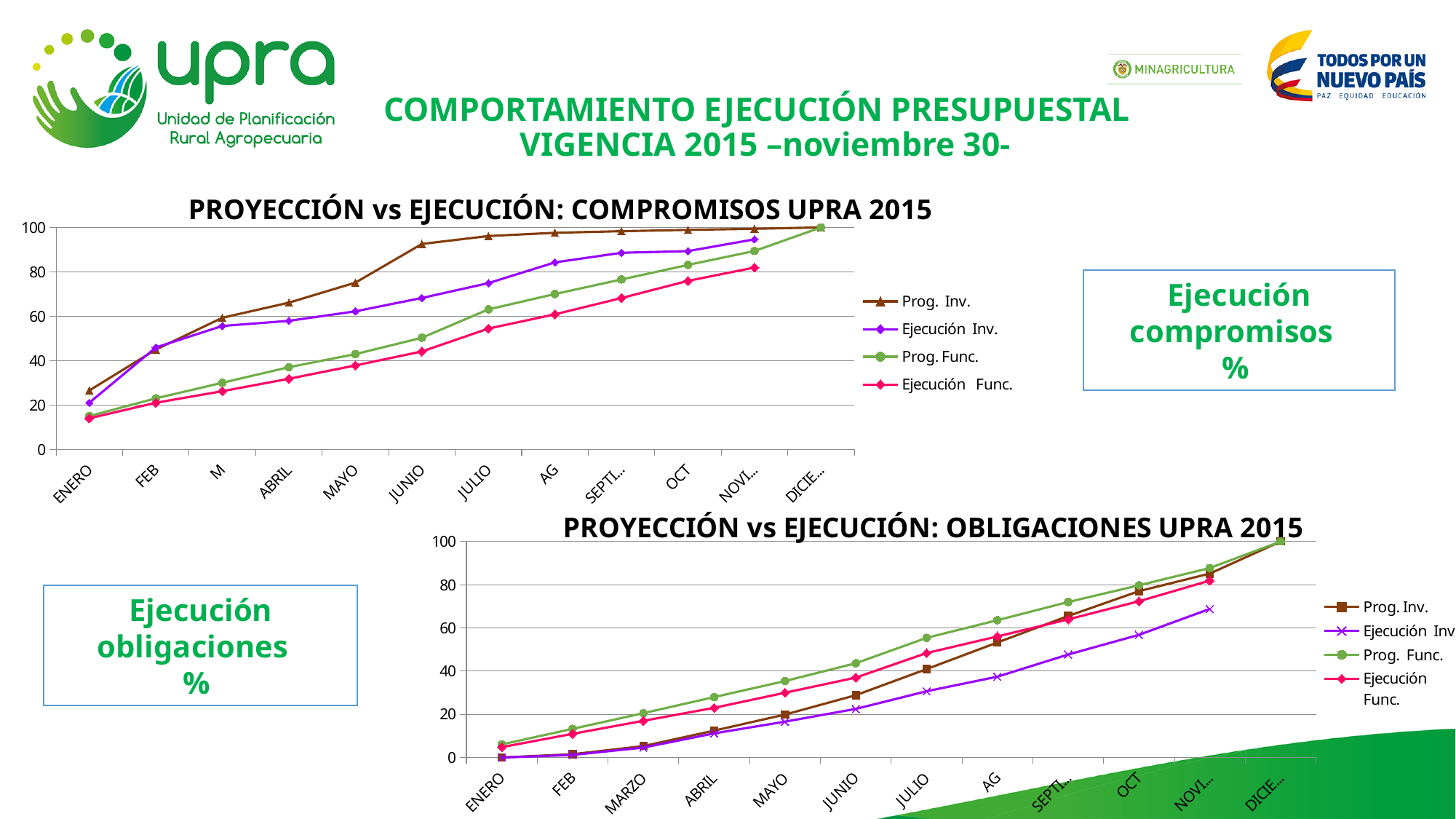
In the 'PROYECCIÓN vs EJECUCIÓN: OBLIGACIONES UPRA 2015' chart, which is larger at SEPTI...: Prog. Func. or Ejecución Inv? Prog. Func. In the 'PROYECCIÓN vs EJECUCIÓN: COMPROMISOS UPRA 2015' chart, is the value of Ejecución Func. at ENERO greater or less than 20? less In the 'PROYECCIÓN vs EJECUCIÓN: OBLIGACIONES UPRA 2015' chart, is the value of Ejecución Inv at NOVI... greater or less than 60? greater How many series does the legend of the 'PROYECCIÓN vs EJECUCIÓN: OBLIGACIONES UPRA 2015' chart list? 4 What is the title of the lower chart on the slide? PROYECCIÓN vs EJECUCIÓN: OBLIGACIONES UPRA 2015 What kind of chart is 'PROYECCIÓN vs EJECUCIÓN: COMPROMISOS UPRA 2015'? Line chart How many months are shown on the x axis of the 'PROYECCIÓN vs EJECUCIÓN: COMPROMISOS UPRA 2015' chart? 12 In the 'PROYECCIÓN vs EJECUCIÓN: COMPROMISOS UPRA 2015' chart, which is larger at MAYO: Prog. Inv. or Ejecución Func.? Prog. Inv. In the 'PROYECCIÓN vs EJECUCIÓN: OBLIGACIONES UPRA 2015' chart, is the value of Prog. Func. at JUNIO greater or less than 40? greater In the 'PROYECCIÓN vs EJECUCIÓN: COMPROMISOS UPRA 2015' chart, what is the value of Prog. Inv. at DICIE...? 100 In the 'PROYECCIÓN vs EJECUCIÓN: OBLIGACIONES UPRA 2015' chart, do the Prog. Inv. values rise or fall from ENERO to DICIE...? Rise